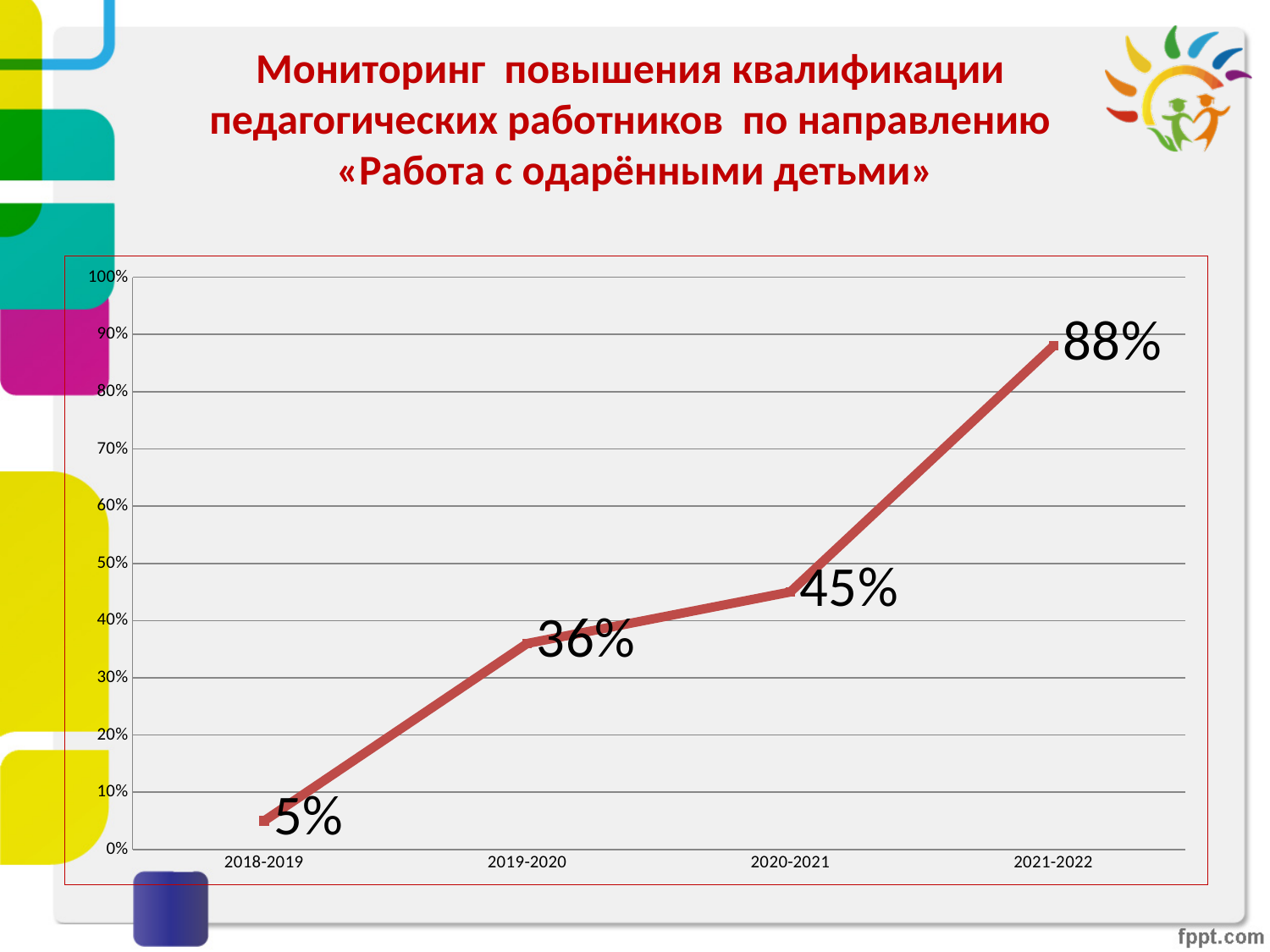
Which period has the lowest value? 2018-2019 What is the value for 2020-2021? 45% Which is larger, the value for 2019-2020 or the value for 2020-2021? 2020-2021 What is the value for 2018-2019? 5% What kind of chart is shown on the slide? line chart What is the difference between the values for 2019-2020 and 2018-2019? 31% What is the value for 2019-2020? 36% What is the value for 2021-2022? 88% How many periods are plotted on the chart? 4 What is the difference between the values for 2021-2022 and 2020-2021? 43% Which period has the highest value? 2021-2022 Do the values rise or fall from 2018-2019 to 2021-2022? rise